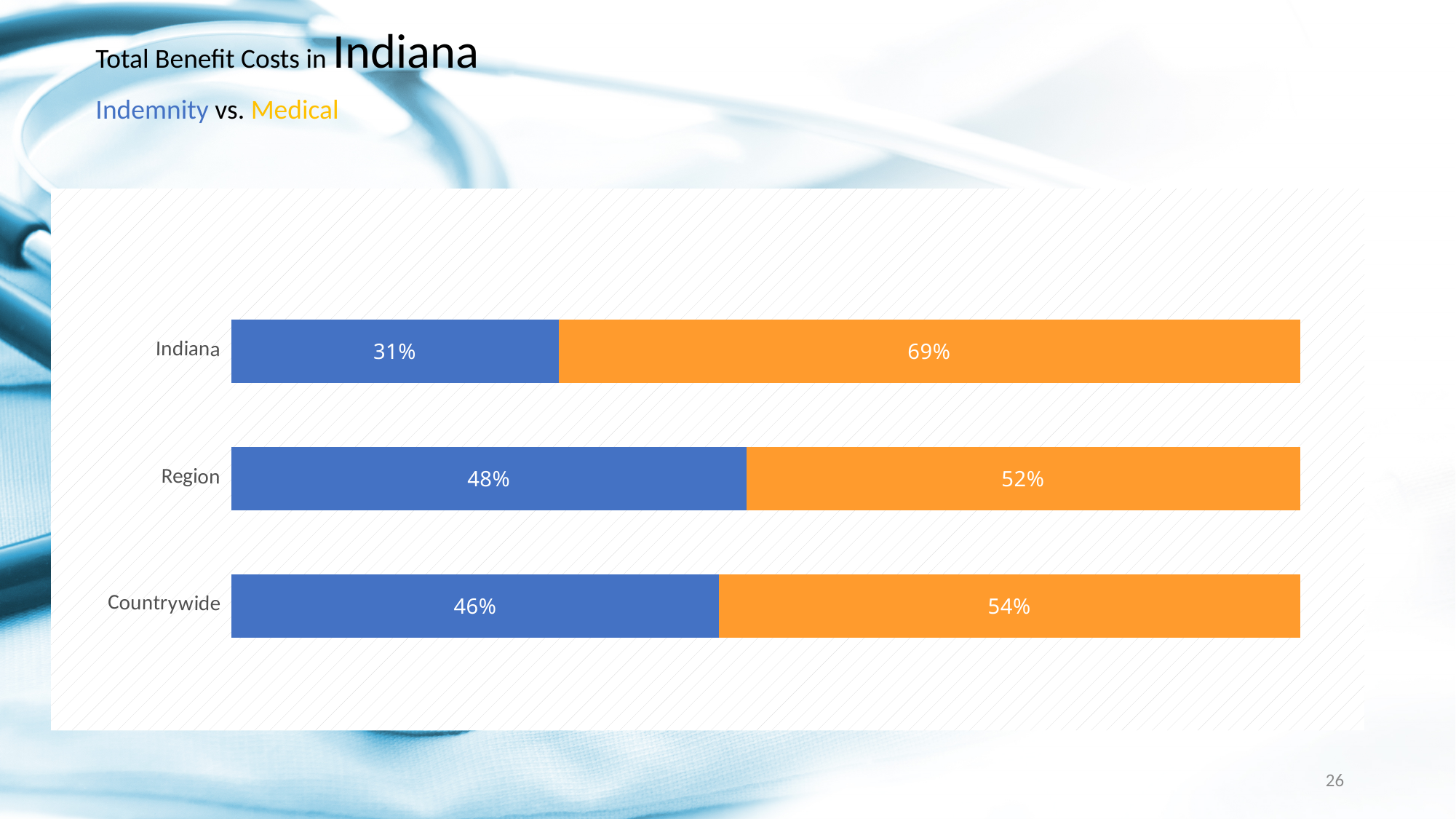
Which is larger for Countrywide, the Indemnity share or the Medical share? Medical Which category has the highest Medical share? Indiana What is the Indemnity share for the Region? 48% What is the Indemnity share of total benefit costs for Indiana? 31% What type of chart is shown on the slide? Stacked bar chart What is the Medical share of total benefit costs for Indiana? 69% What is the total of the Indemnity and Medical segments for the Region bar? 100% Which category has the lowest Indemnity share? Indiana How many categories are shown in the chart? 3 What is the Medical share for Countrywide? 54% What is the difference between the Indemnity shares for Region and Indiana? 17% What is the difference between the Medical and Indemnity shares for Indiana? 38%